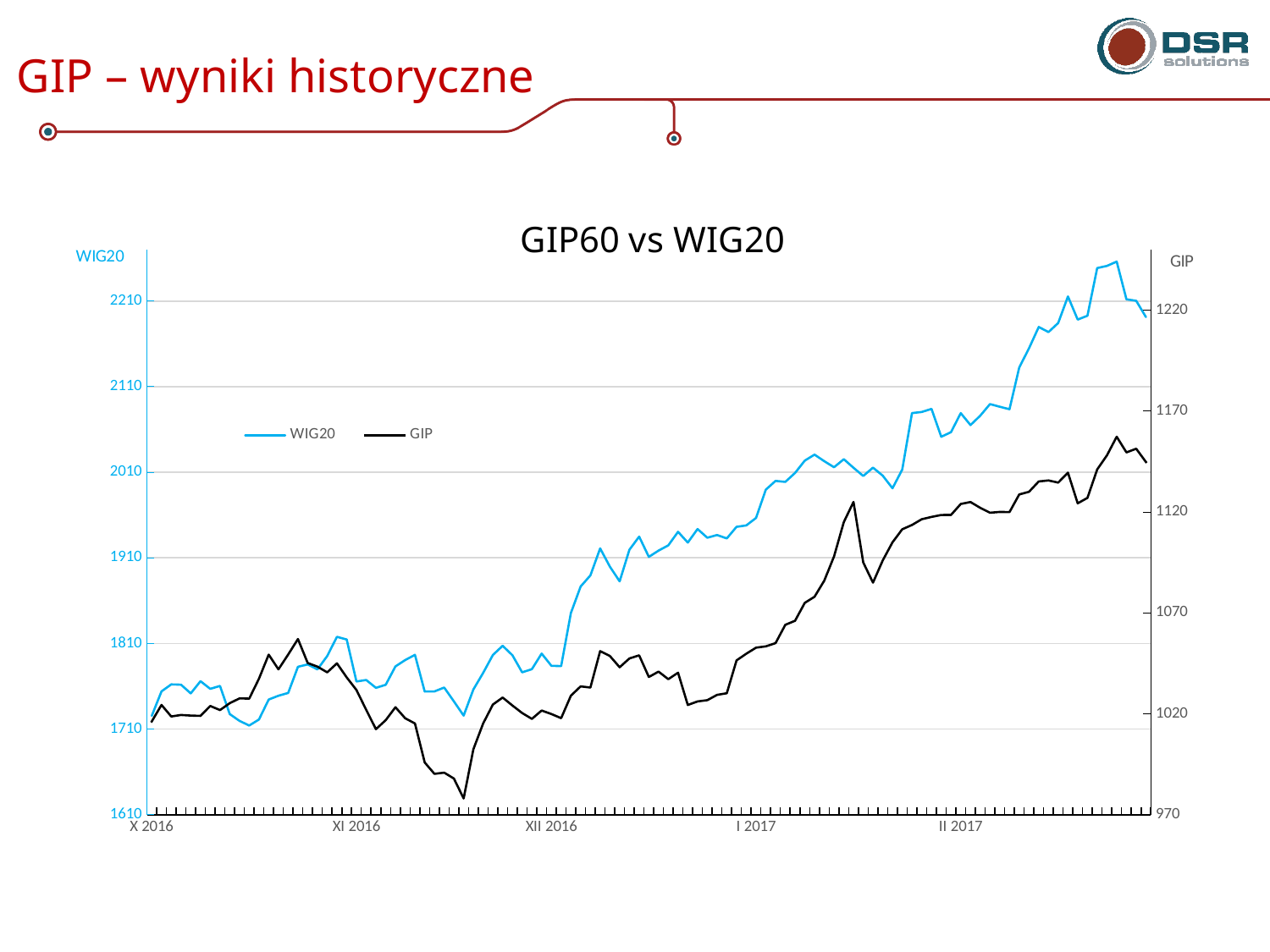
Overall, does the GIP line rise or fall from X 2016 to the end of the chart? rise Is the WIG20 value at I 2017 greater or less than 1910? greater Overall, does the WIG20 line rise or fall from X 2016 to the end of the chart? rise Is the WIG20 value at the start of the chart (X 2016) greater or less than 1810? less What is the title of the chart? GIP60 vs WIG20 Is the GIP value at the end of the chart greater or less than 1120? greater What kind of chart is shown on the slide? line chart Which series is drawn in blue in the chart? WIG20 How many series does the legend of the chart list? 2